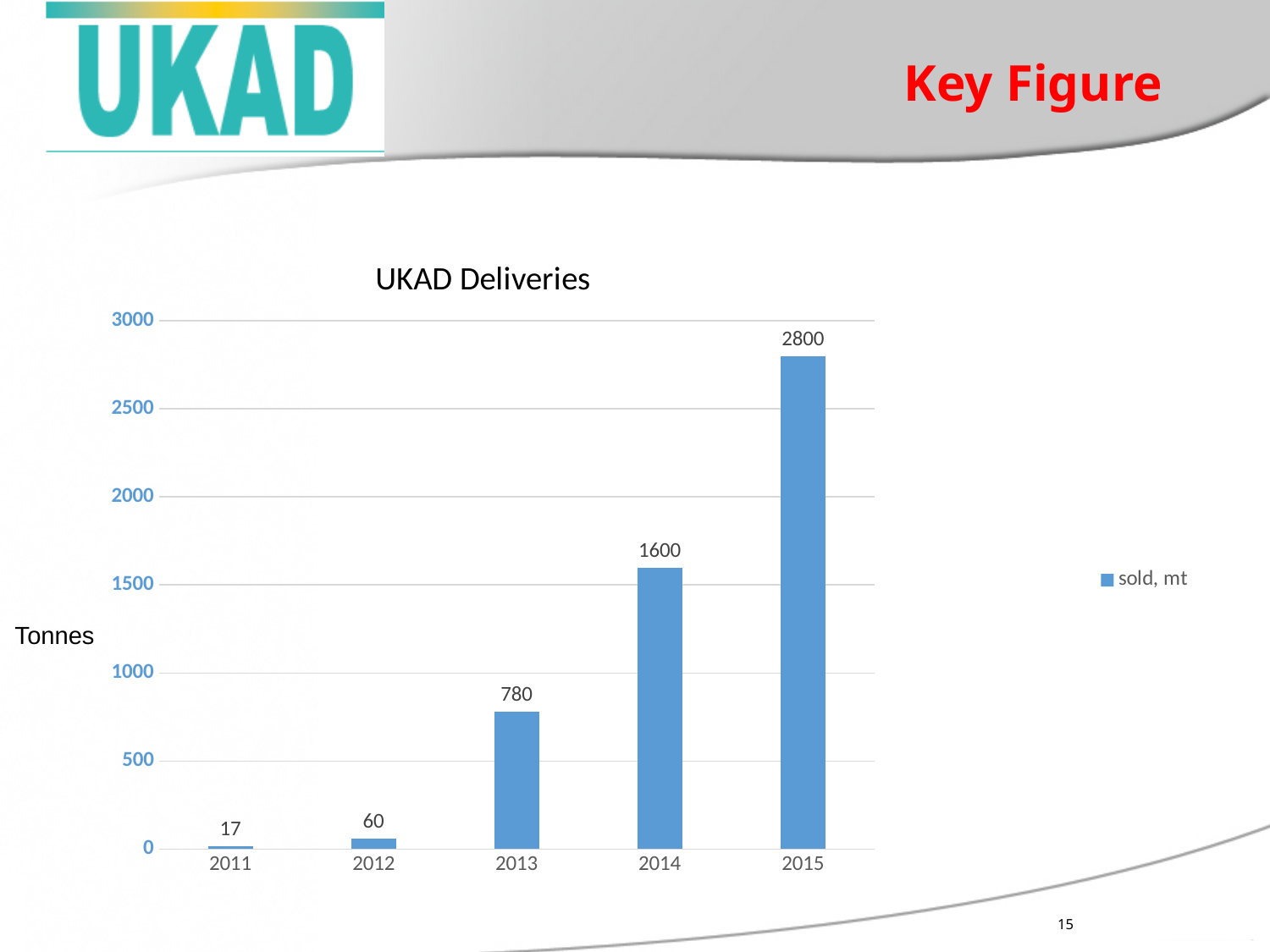
Is the value for 2014 in the UKAD Deliveries chart greater or less than 1500? greater What is the value for 2013 in the UKAD Deliveries chart? 780 How many years are shown on the x axis of the UKAD Deliveries chart? 5 What is the difference between the values for 2013 and 2012 in the UKAD Deliveries chart? 720 What is the value for 2011 in the UKAD Deliveries chart? 17 What is the value for 2015 in the UKAD Deliveries chart? 2800 Which year has the lowest value in the UKAD Deliveries chart? 2011 What kind of chart is the UKAD Deliveries chart? bar chart Which is larger in the UKAD Deliveries chart, the value for 2013 or the value for 2014? 2014 Do the values in the UKAD Deliveries chart rise or fall from 2011 to 2015? rise What is the difference between the values for 2015 and 2014 in the UKAD Deliveries chart? 1200 Which year has the highest value in the UKAD Deliveries chart? 2015